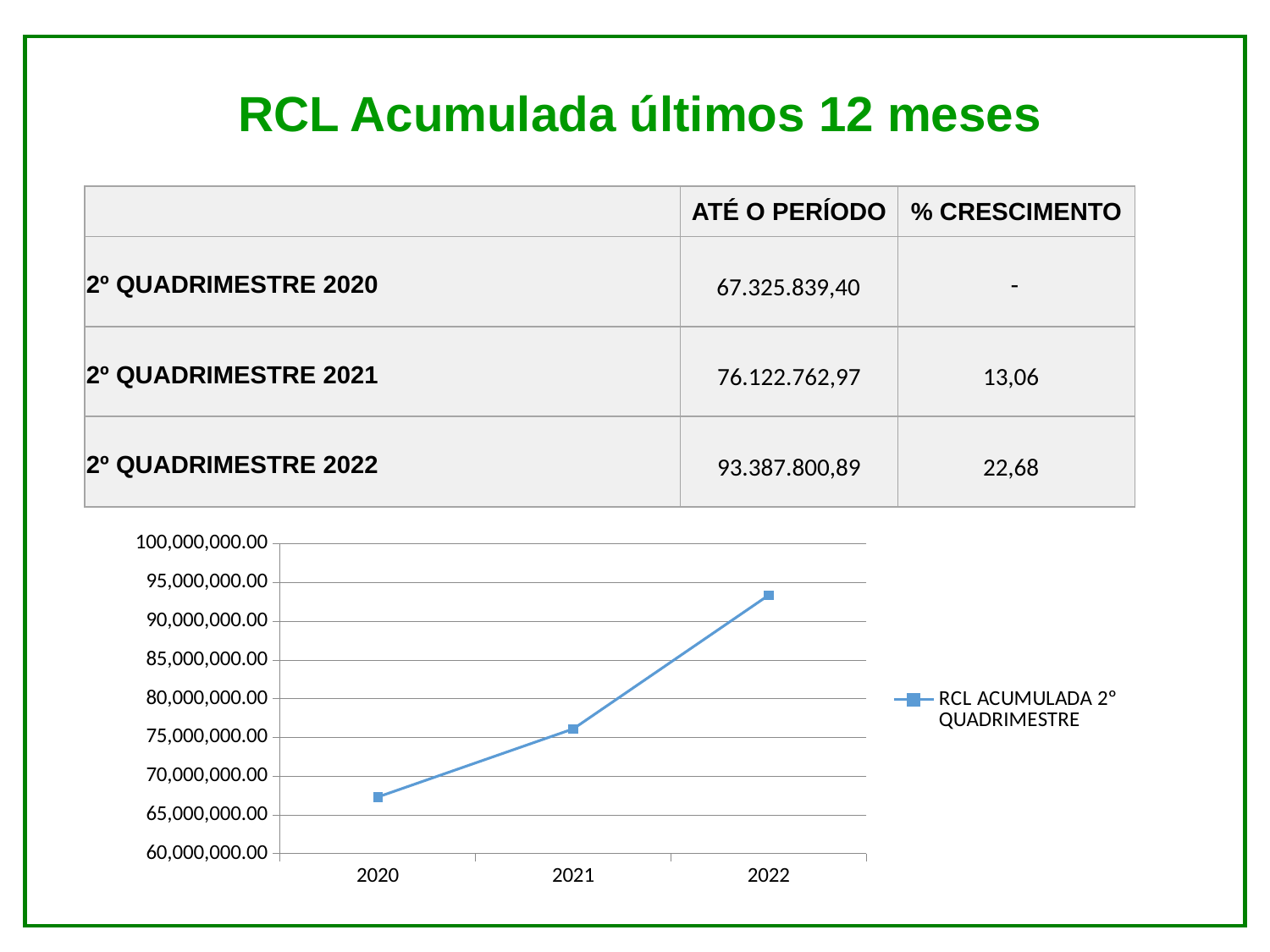
What kind of chart is shown on the slide? line chart Which year has the highest value on the line chart? 2022 Is the value for 2021 on the line chart greater or less than 75,000,000.00? greater Do the values on the line chart rise or fall from 2020 to 2022? rise Which is larger on the line chart, the value for 2021 or the value for 2022? 2022 How many series does the chart legend list? 1 What is the name of the series shown in the chart legend? RCL ACUMULADA 2° QUADRIMESTRE According to the table on the slide, what is the RCL accumulated value for the 2º Quadrimestre 2022? 93.387.800,89 Which year has the lowest value on the line chart? 2020 Is the value for 2020 on the line chart greater or less than 70,000,000.00? less How many data points are plotted on the line chart? 3 Is the value for 2022 on the line chart greater or less than 90,000,000.00? greater